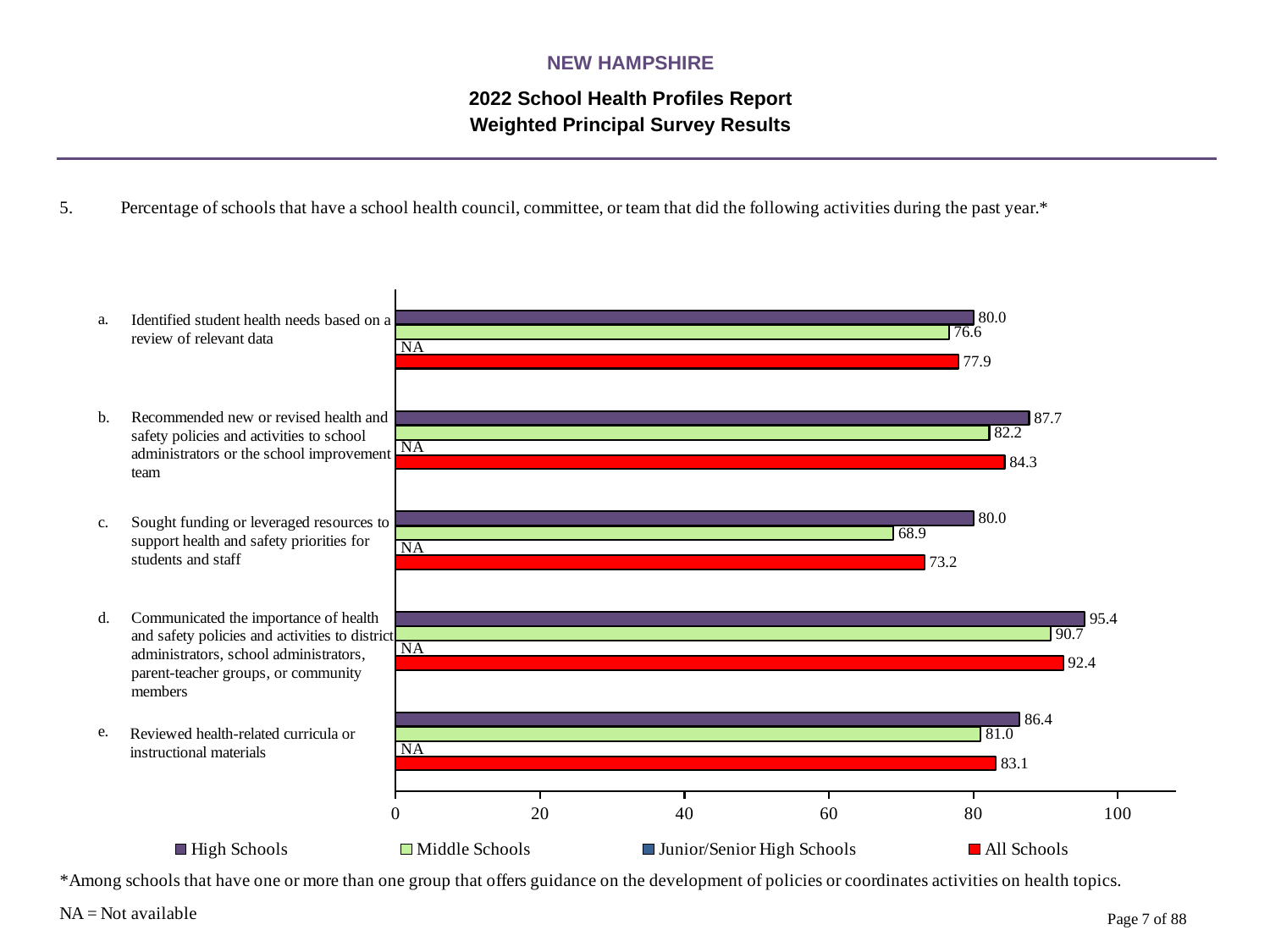
What is the Middle Schools value for activity c, sought funding or leveraged resources to support health and safety priorities? 68.9 How many activities are listed on the chart? 5 Which is larger for activity a, identified student health needs: the High Schools value or the All Schools value? High Schools How many series does the legend list? 4 What is the difference between the High Schools and Middle Schools values for activity c, sought funding or leveraged resources? 11.1 Which activity has the highest All Schools value? d. Communicated the importance of health and safety policies and activities What is the Middle Schools value for activity e, reviewed health-related curricula or instructional materials? 81.0 What is the High Schools value for activity d, communicated the importance of health and safety policies and activities? 95.4 What is the All Schools value for activity b, recommended new or revised health and safety policies and activities? 84.3 What value is shown for Junior/Senior High Schools for each activity? NA Which activity has the lowest Middle Schools value? c. Sought funding or leveraged resources to support health and safety priorities What kind of chart is shown on the slide? Bar chart